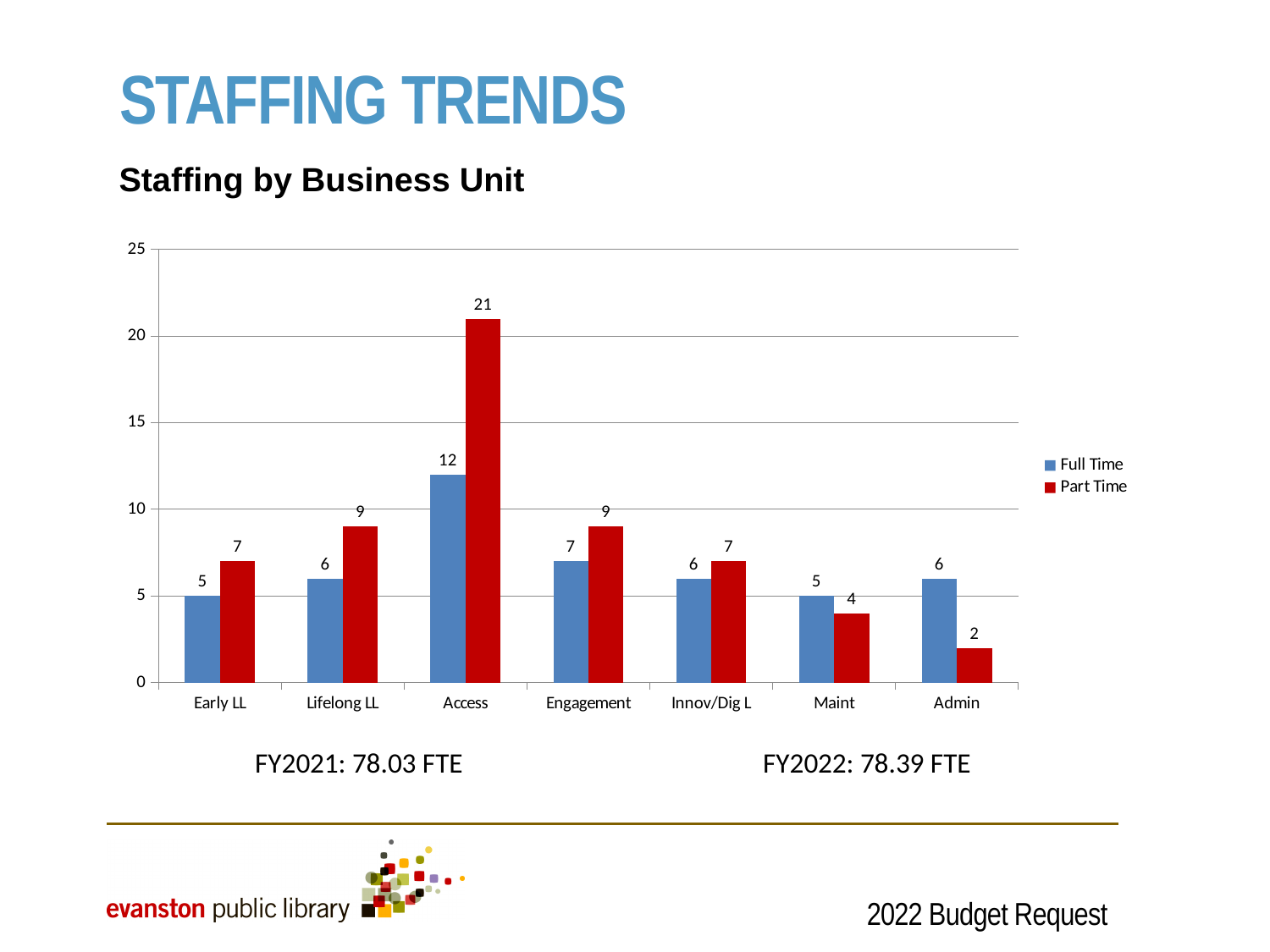
What is the difference between the Part Time and Full Time values for Access? 9 What is the Part Time value for Admin? 2 How many series does the legend list? 2 What is the Part Time value for Access? 21 Which business unit has the lowest Part Time value? Admin What kind of chart is shown on the slide? Bar chart Which business unit has the highest Full Time value? Access How many business units are shown on the x axis? 7 Which is larger for Maint, the Full Time value or the Part Time value? Full Time What is the Full Time value for Lifelong LL? 6 What is the total of the Full Time and Part Time values for Engagement? 16 What colour represents the Part Time series? Red